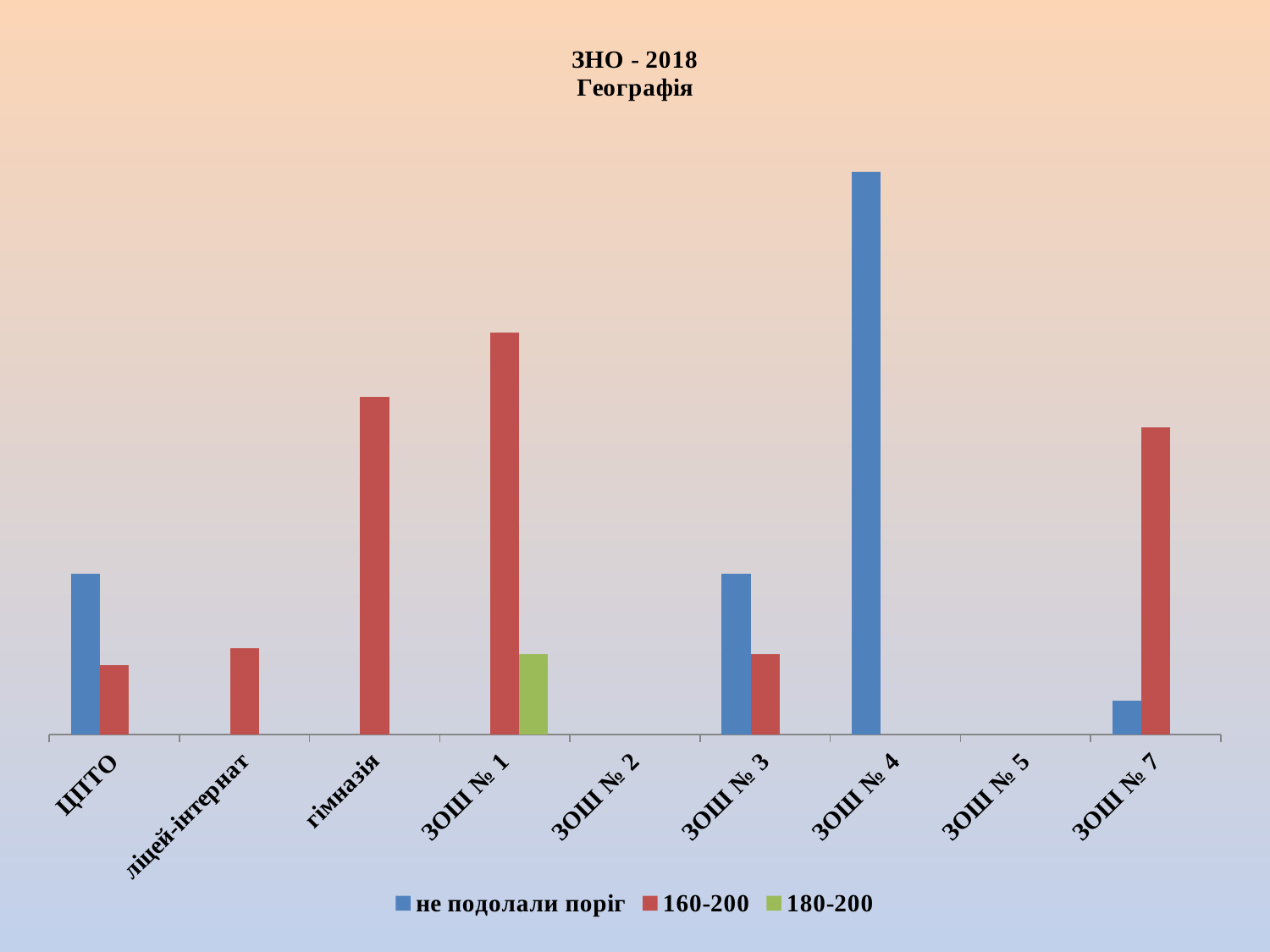
Which category has the highest bar for the series "160-200"? ЗОШ № 1 For the series "160-200", which category has the larger bar: гімназія or ЗОШ № 1? ЗОШ № 1 Which category has the highest bar for the series "не подолали поріг"? ЗОШ № 4 For ЦПТО, which series has the larger bar: "не подолали поріг" or "160-200"? не подолали поріг Which category is the only one with a bar for the series "180-200"? ЗОШ № 1 How many categories are shown on the x axis? 9 Which categories have no bars at all in the chart? ЗОШ № 2 and ЗОШ № 5 What kind of chart is shown on the slide? bar chart How many series does the legend list? 3 For ЗОШ № 7, which series has the larger bar: "не подолали поріг" or "160-200"? 160-200 What is the title of the chart? ЗНО - 2018 Географія